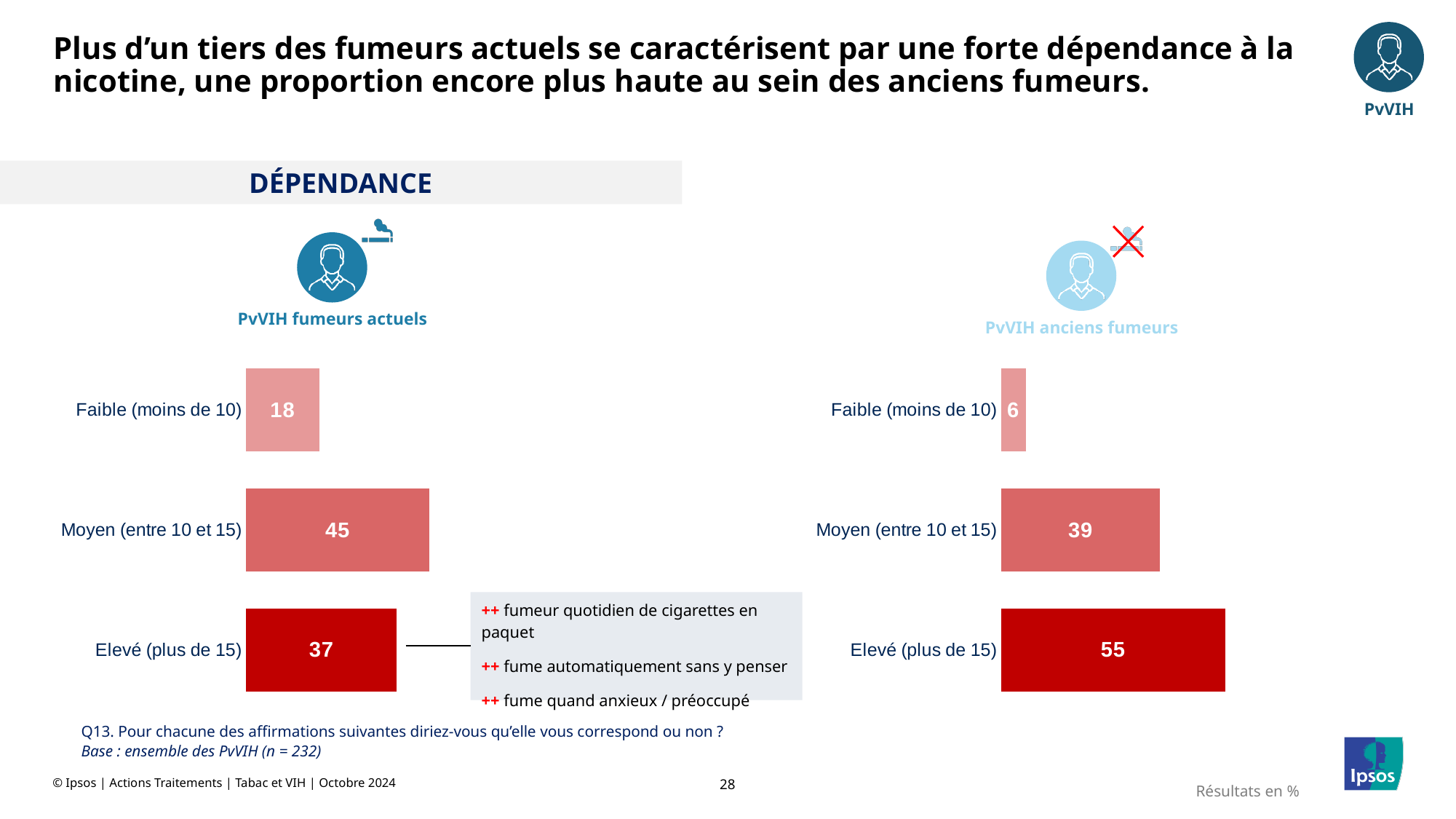
In the 'PvVIH fumeurs actuels' chart, which category has the highest value? Moyen (entre 10 et 15) How many categories are shown in the 'PvVIH fumeurs actuels' chart? 3 In the 'PvVIH anciens fumeurs' chart, what is the value for 'Faible (moins de 10)'? 6 In the 'PvVIH anciens fumeurs' chart, which category has the lowest value? Faible (moins de 10) What is the difference between the 'Elevé (plus de 15)' values in the 'PvVIH anciens fumeurs' chart and the 'PvVIH fumeurs actuels' chart? 18 Which is larger: 'Moyen (entre 10 et 15)' in the 'PvVIH fumeurs actuels' chart or 'Moyen (entre 10 et 15)' in the 'PvVIH anciens fumeurs' chart? PvVIH fumeurs actuels In the 'PvVIH anciens fumeurs' chart, what is the value for 'Elevé (plus de 15)'? 55 In the 'PvVIH fumeurs actuels' chart, what is the difference between 'Moyen (entre 10 et 15)' and 'Faible (moins de 10)'? 27 In the 'PvVIH fumeurs actuels' chart, what is the value for 'Moyen (entre 10 et 15)'? 45 In the 'PvVIH anciens fumeurs' chart, which category has the highest value? Elevé (plus de 15) In the 'PvVIH fumeurs actuels' chart, what is the value for 'Elevé (plus de 15)'? 37 What kind of chart is the 'PvVIH anciens fumeurs' chart? Bar chart